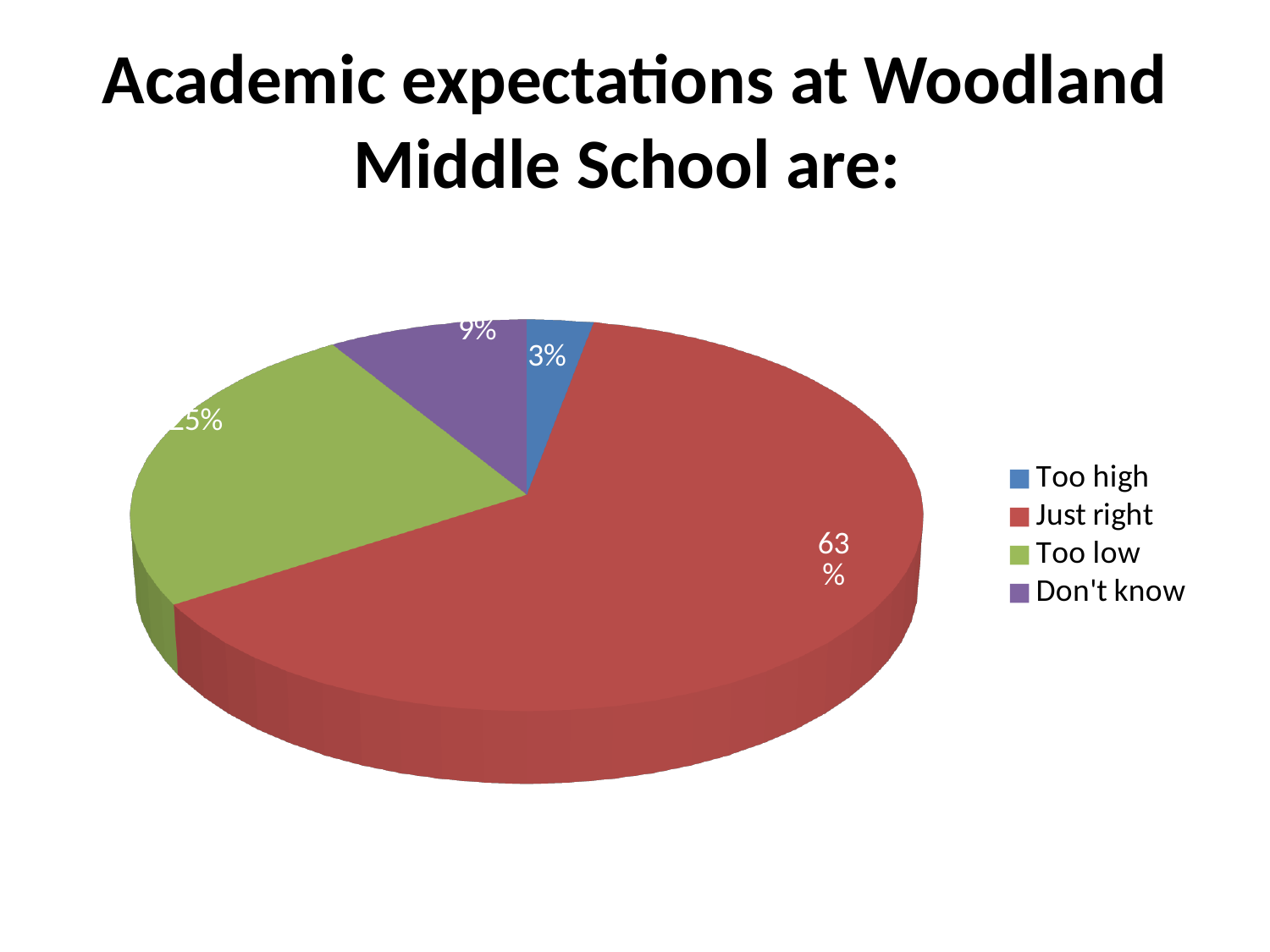
What kind of chart is shown on the slide? pie chart Which category has the smallest slice of the pie? Too high How many categories does the pie chart have? 4 What is the difference between the "Don't know" and "Too high" values? 6% What share of the pie does the "Just right" slice represent? 63% What is the title of the slide? Academic expectations at Woodland Middle School are: What is the difference between the "Just right" and "Don't know" values? 54% Which is larger, the "Don't know" slice or the "Too high" slice? Don't know What colour is the "Just right" slice? red What is the value shown for "Too high"? 3% Which category has the largest slice of the pie? Just right What is the value shown for "Don't know"? 9%